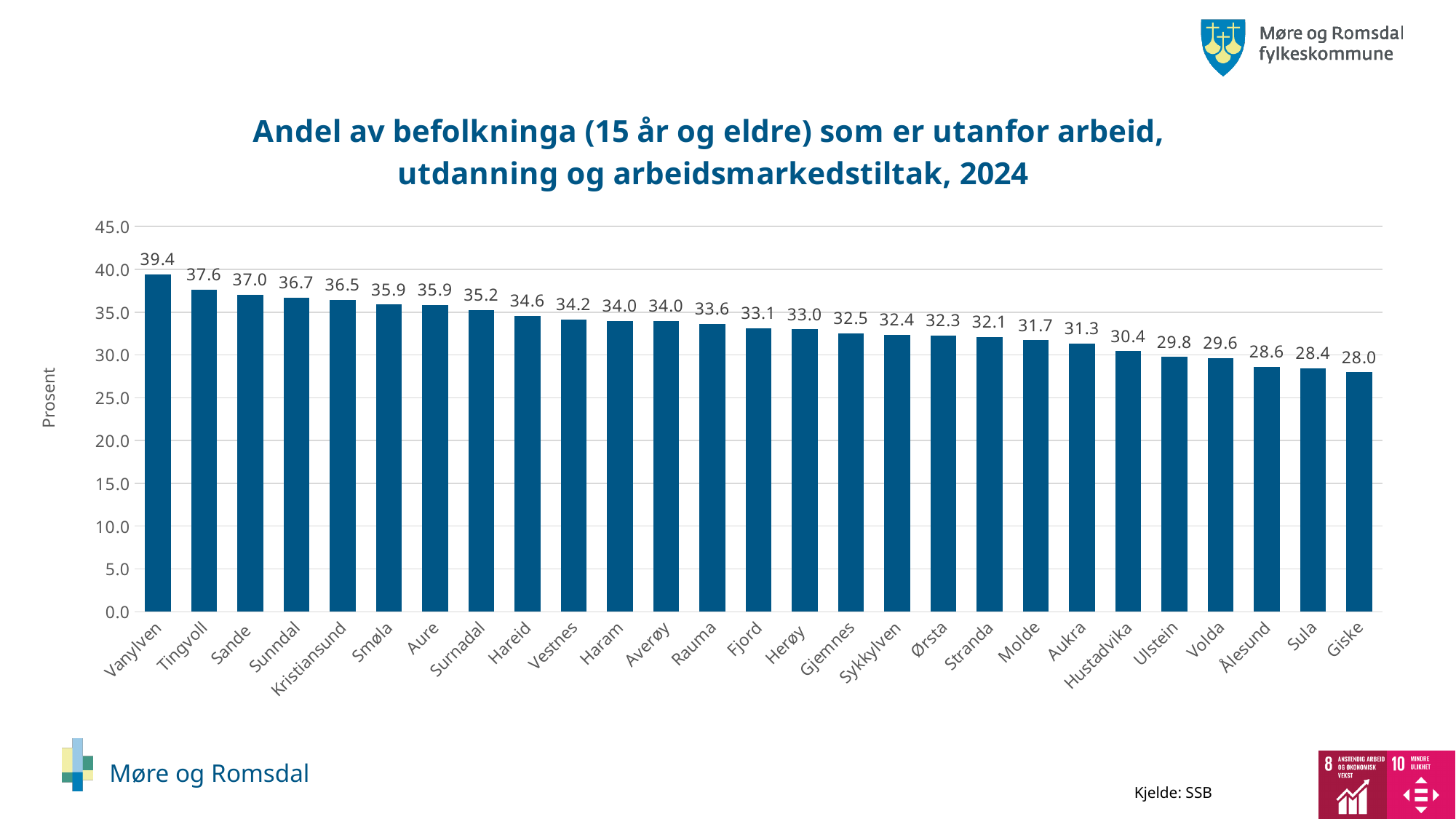
What kind of chart is shown on the slide? bar chart What is the difference between the values for Tingvoll and Sunndal? 0.9 What is the value for Kristiansund? 36.5 Which municipality has the lowest value? Giske What is the value for Ålesund? 28.6 Is the value for Sula greater or less than 30.0? less What is the value for Molde? 31.7 Which has a higher value, Hareid or Ulstein? Hareid What is the label on the vertical axis? Prosent Which municipality has the highest value? Vanylven What is the difference between the values for Vanylven and Giske? 11.4 How many municipalities are shown in the chart? 27